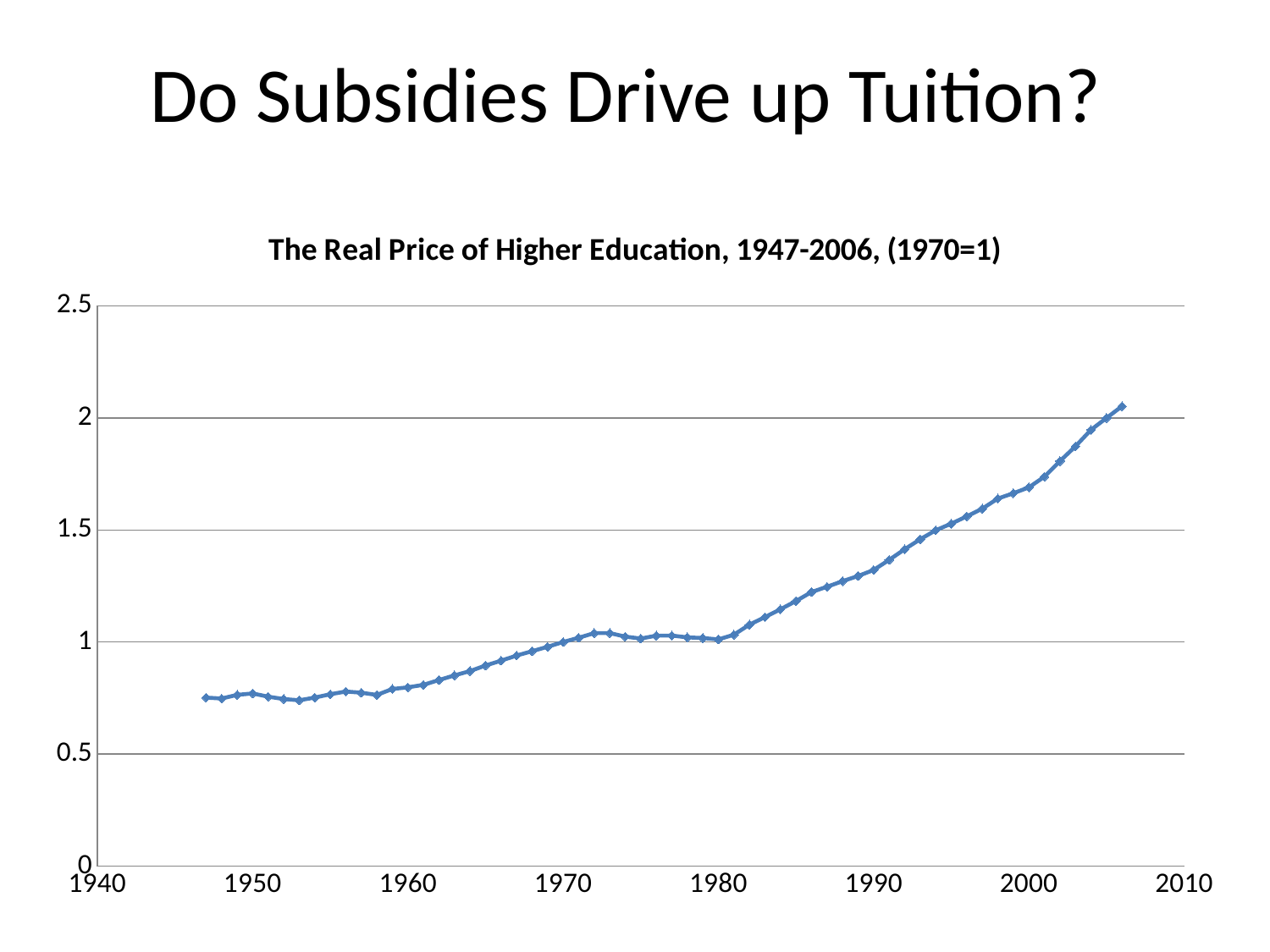
Is the value for 1990 greater or less than 1? greater Is the value for 2006 greater or less than 1.5? greater What is the highest value shown on the vertical axis? 2.5 Is the value for 2000 greater or less than 1.5? greater What kind of chart is shown on the slide? line chart Overall, do the values rise or fall from 1947 to 2006? rise In which year does the line reach its highest value? 2006 What is the title of the chart? The Real Price of Higher Education, 1947-2006, (1970=1) Which year has the larger value, 1950 or 2000? 2000